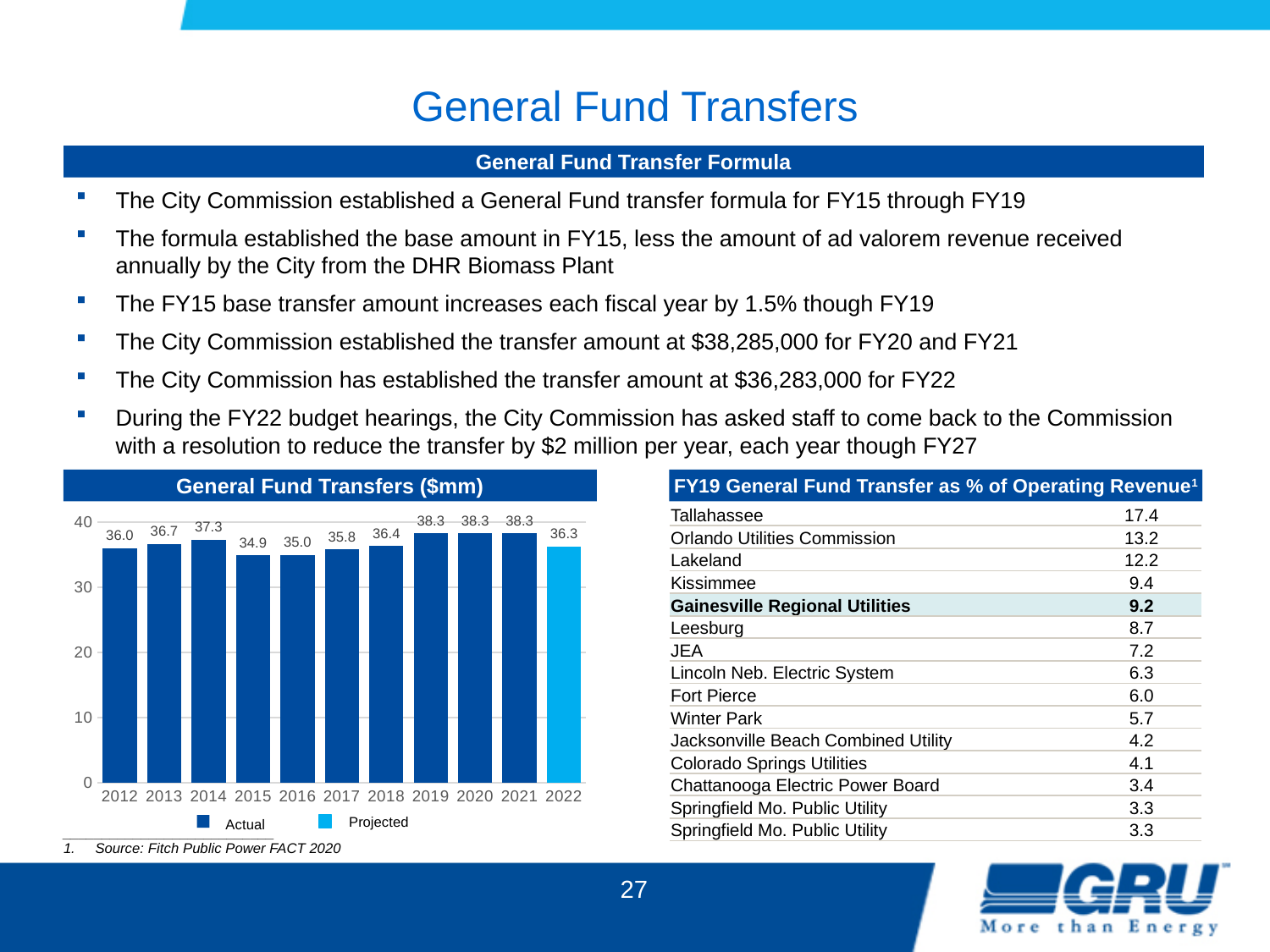
Did the General Fund Transfer rise or fall from 2014 to 2015? fall What is the difference between the General Fund Transfer in 2021 and in 2022? 2.0 Which year has the lowest General Fund Transfer? 2015 How many series does the legend of the General Fund Transfers chart list? 2 What is the highest General Fund Transfer value shown in the chart? 38.3 Which year had a larger General Fund Transfer, 2014 or 2018? 2014 Which series in the General Fund Transfers chart is shown in light blue? Projected What was the General Fund Transfer in 2015? 34.9 How many years are shown on the x axis of the General Fund Transfers chart? 11 What was the General Fund Transfer in 2012? 36.0 What is the projected General Fund Transfer for 2022? 36.3 What type of chart is used to show General Fund Transfers ($mm)? bar chart